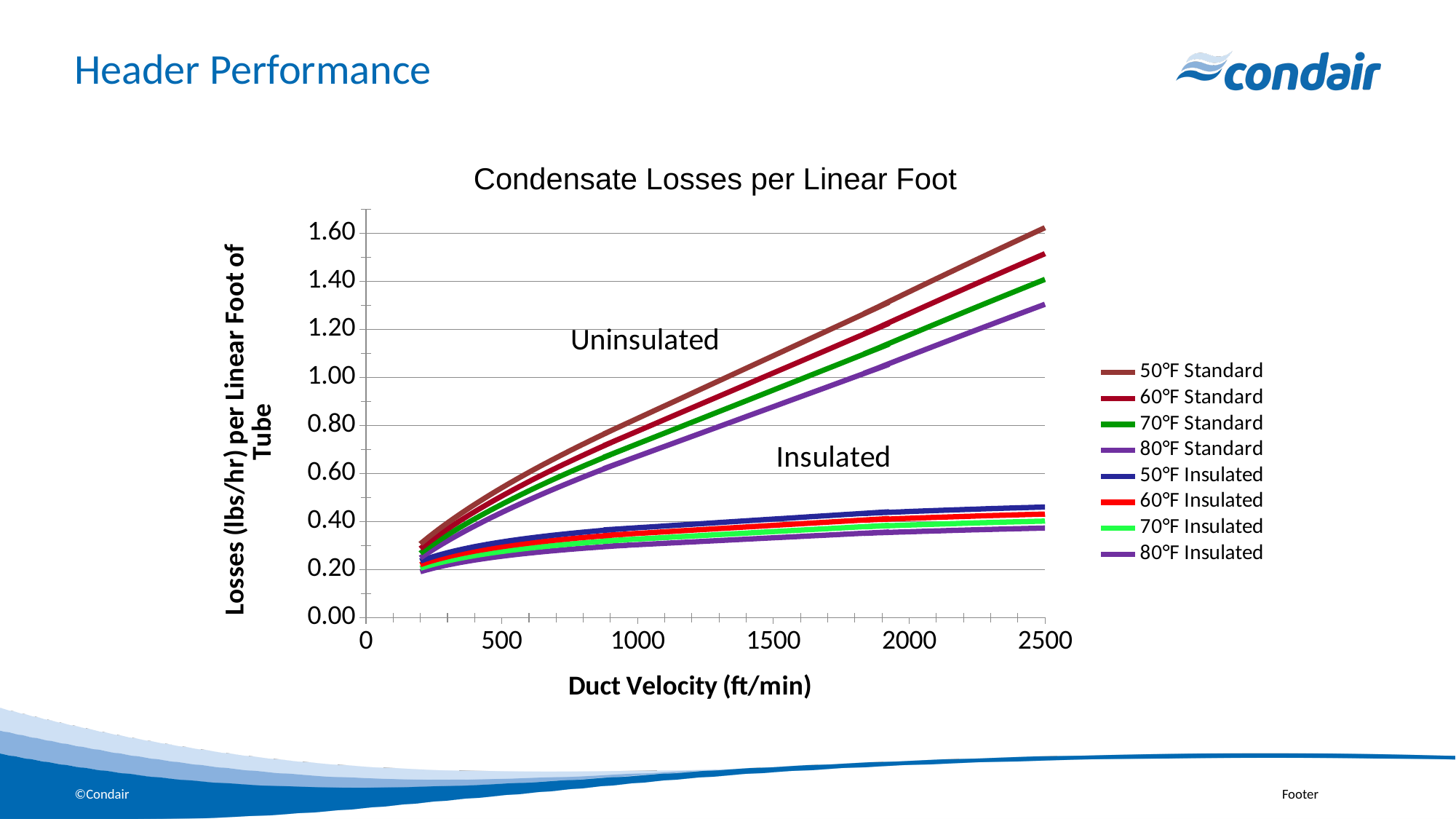
What kind of chart is shown on the slide? Line chart Do the losses for the 50°F Standard series rise or fall as duct velocity increases? Rise Is the value for 80°F Standard at 2500 ft/min greater or less than 1.20? greater Which series has the lowest losses at a duct velocity of 2500 ft/min? 80°F Insulated What is the x-axis title of the chart? Duct Velocity (ft/min) How many series does the legend list? 8 At 2500 ft/min, which is larger: the losses for 50°F Standard or for 80°F Insulated? 50°F Standard Is the value for 50°F Insulated at 2500 ft/min greater or less than 0.60? less What is the title of the chart? Condensate Losses per Linear Foot Which series has the highest losses at a duct velocity of 2500 ft/min? 50°F Standard Is the value for 50°F Standard at 2500 ft/min greater or less than 1.40? greater